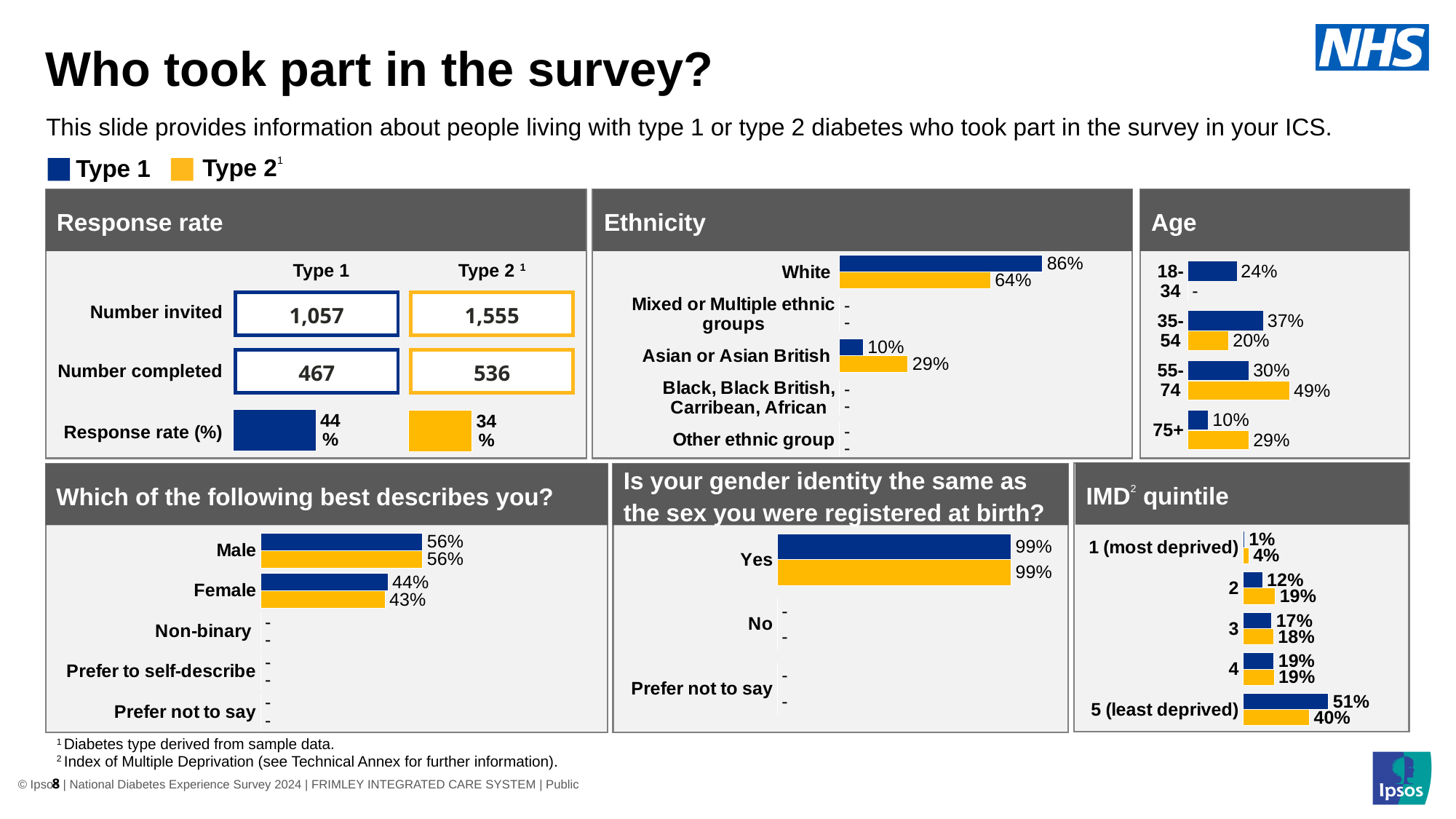
In the IMD quintile chart, is the Type 1 value for 5 (least deprived) larger or smaller than the Type 2 value? larger In the Ethnicity chart, what is the Type 1 value for White? 86% In the IMD quintile chart, what is the Type 1 value for 5 (least deprived)? 51% In the Ethnicity chart, what is the Type 2 value for Asian or Asian British? 29% How many categories are shown in the 'Which of the following best describes you?' chart? 5 In the Age chart, what is the Type 2 value for 55-74? 49% How many series does the legend at the top of the slide list? 2 In the IMD quintile chart, which quintile has the lowest Type 2 value? 1 (most deprived) In the 'Which of the following best describes you?' chart, what is the Type 2 value for Female? 43% In the Age chart, which age group has the highest Type 1 value? 35-54 In the Age chart, what is the difference between the Type 2 and Type 1 values for 75+? 19% In the Response rate panel, what is the Number completed for Type 2? 536